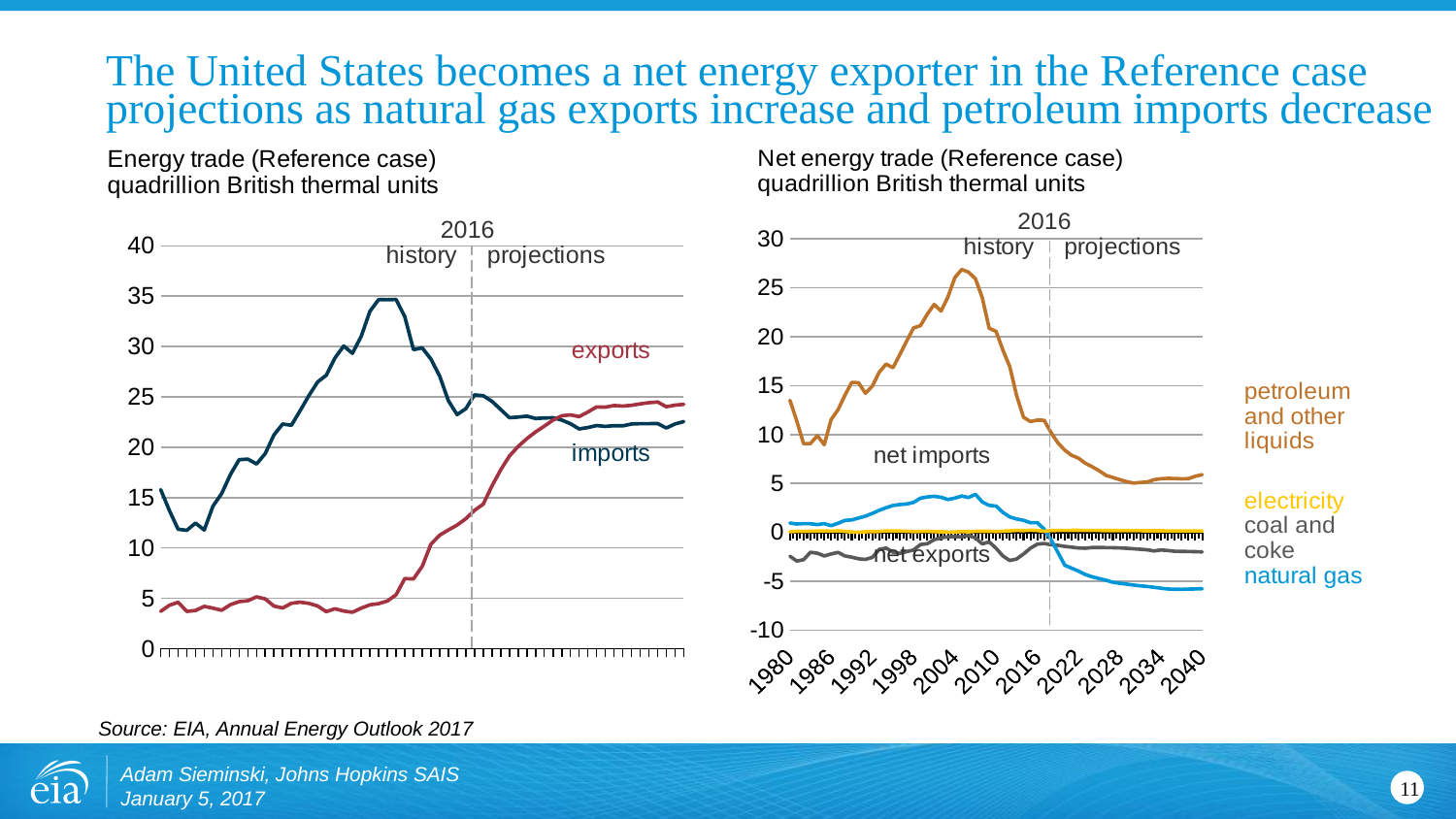
How many series are labelled on the left chart, "Energy trade (Reference case)"? 2 On the left chart, "Energy trade (Reference case)", is the value for exports in 1980 greater or less than 10? less What kind of chart is the left chart titled "Energy trade (Reference case)"? line chart On the right chart, "Net energy trade (Reference case)", is the peak value for petroleum and other liquids greater or less than 25? greater What year does the vertical dashed line separating history from projections mark on both charts? 2016 On the left chart, "Energy trade (Reference case)", is the peak value of imports greater or less than 30? greater On the left chart, "Energy trade (Reference case)", do exports generally rise or fall from 1980 to 2040? rise How many series are labelled on the right chart, "Net energy trade (Reference case)"? 4 On the right chart, "Net energy trade (Reference case)", does the petroleum and other liquids line rise or fall between 2010 and 2030? fall